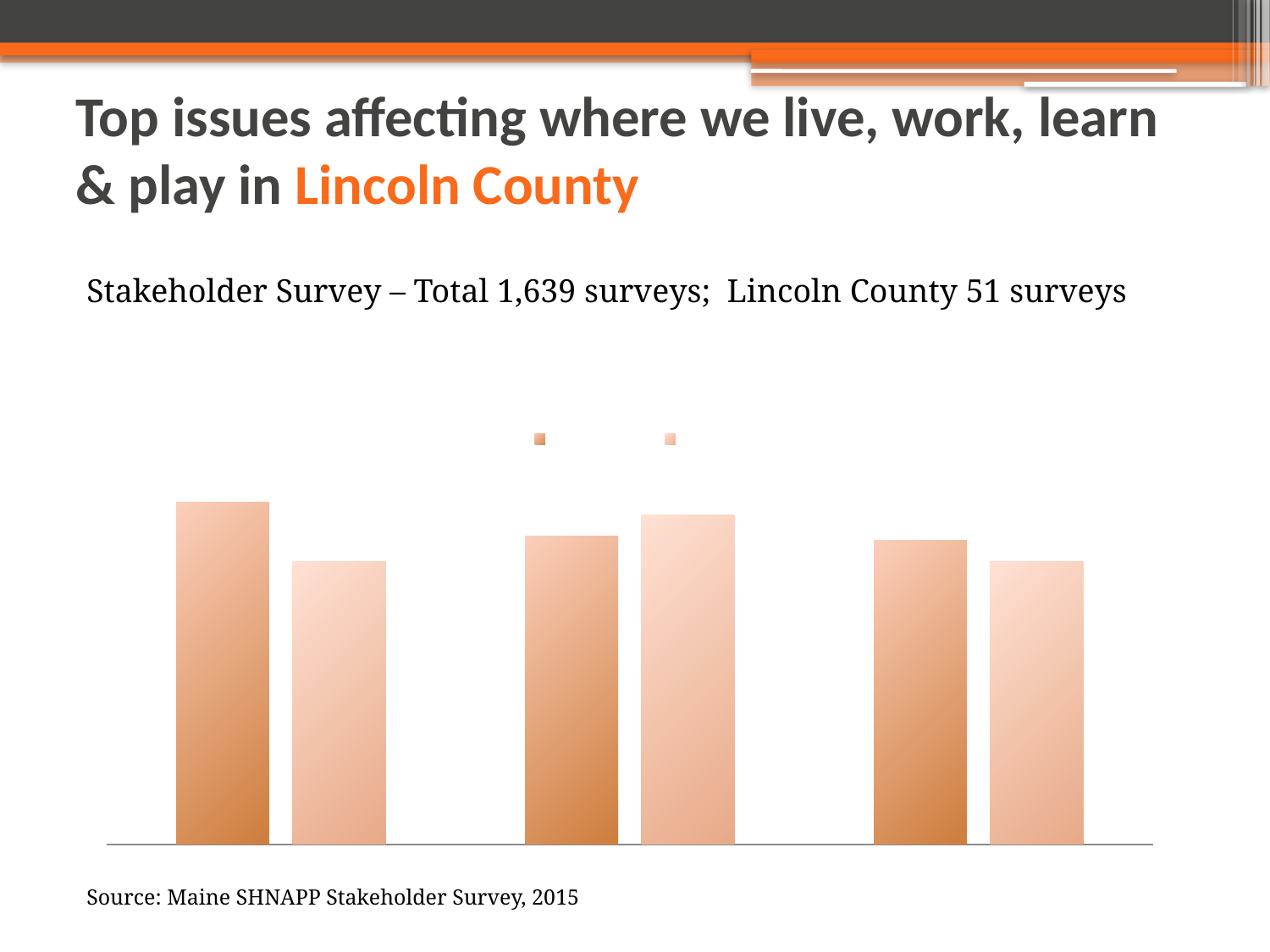
Does the chart display any numeric axis labels or data labels? No In the middle group of bars, which bar is taller, the darker orange bar or the lighter orange bar? the lighter orange bar How many series does the chart's legend show? 2 What kind of chart is shown on the slide? bar chart What two colours are used for the bars in the chart? darker orange and lighter orange Which single bar on the chart is the tallest? the darker orange bar in the leftmost group How many bars are plotted in total on the chart? 6 In the leftmost group of bars, which bar is taller, the darker orange bar or the lighter orange bar? the darker orange bar How many groups of bars does the chart show? 3